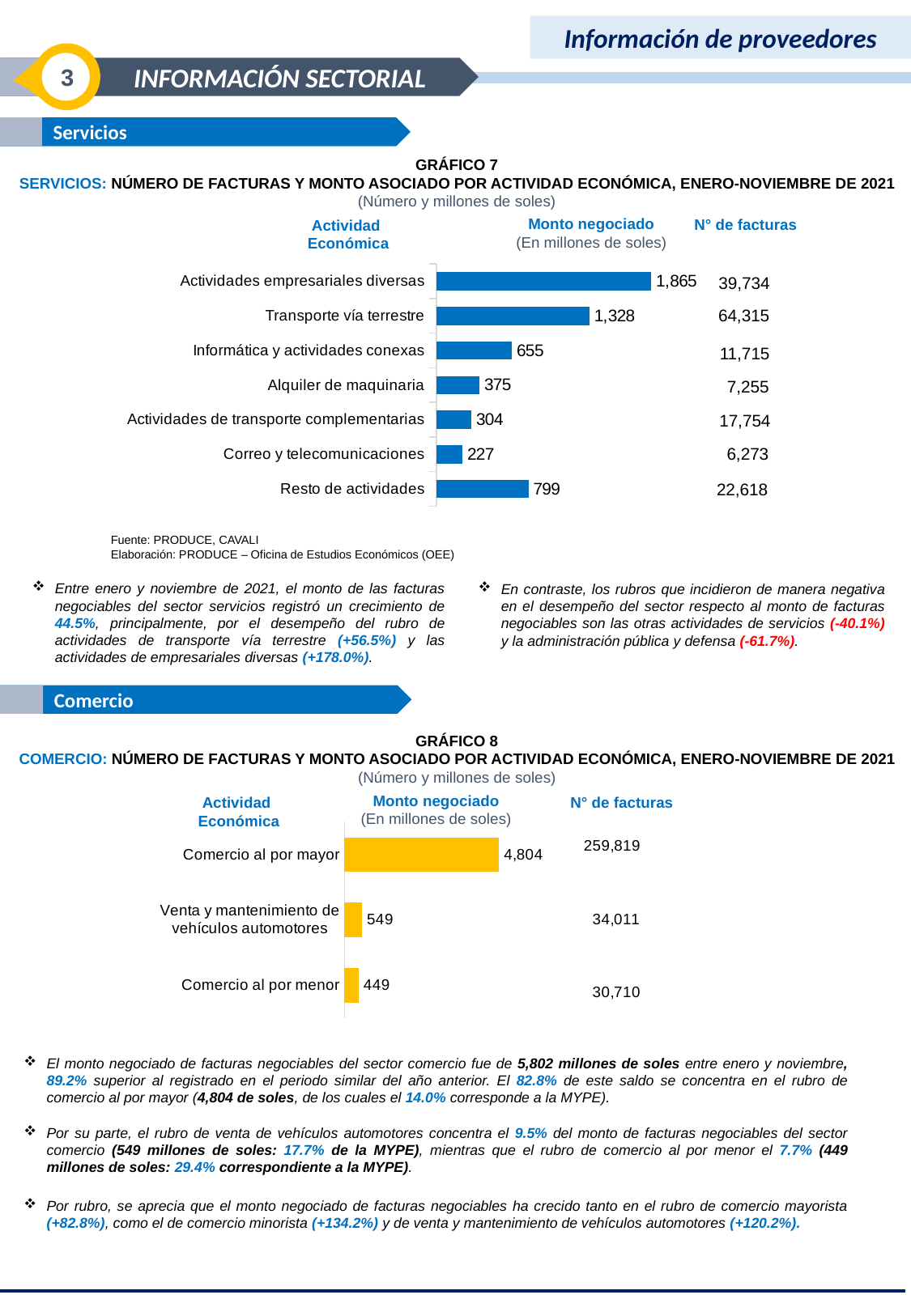
In Gráfico 7 (Servicios), what is the monto negociado for Transporte vía terrestre? 1,328 In Gráfico 7 (Servicios), how many facturas are listed for Transporte vía terrestre? 64,315 In Gráfico 7 (Servicios), which has a larger monto negociado: Alquiler de maquinaria or Resto de actividades? Resto de actividades In Gráfico 8 (Comercio), which actividad económica has the lowest monto negociado? Comercio al por menor In Gráfico 7 (Servicios), how many actividades económicas are plotted? 7 What kind of chart is Gráfico 8 (Comercio)? Bar chart In Gráfico 7 (Servicios), which actividad económica has the highest monto negociado? Actividades empresariales diversas In Gráfico 8 (Comercio), what is the monto negociado for Comercio al por mayor? 4,804 In Gráfico 7 (Servicios), which actividad económica has the lowest monto negociado? Correo y telecomunicaciones In Gráfico 8 (Comercio), what is the difference in monto negociado between Venta y mantenimiento de vehículos automotores and Comercio al por menor? 100 In Gráfico 7 (Servicios), what is the difference in monto negociado between Actividades empresariales diversas and Transporte vía terrestre? 537 In Gráfico 8 (Comercio), how many facturas are listed for Comercio al por mayor? 259,819